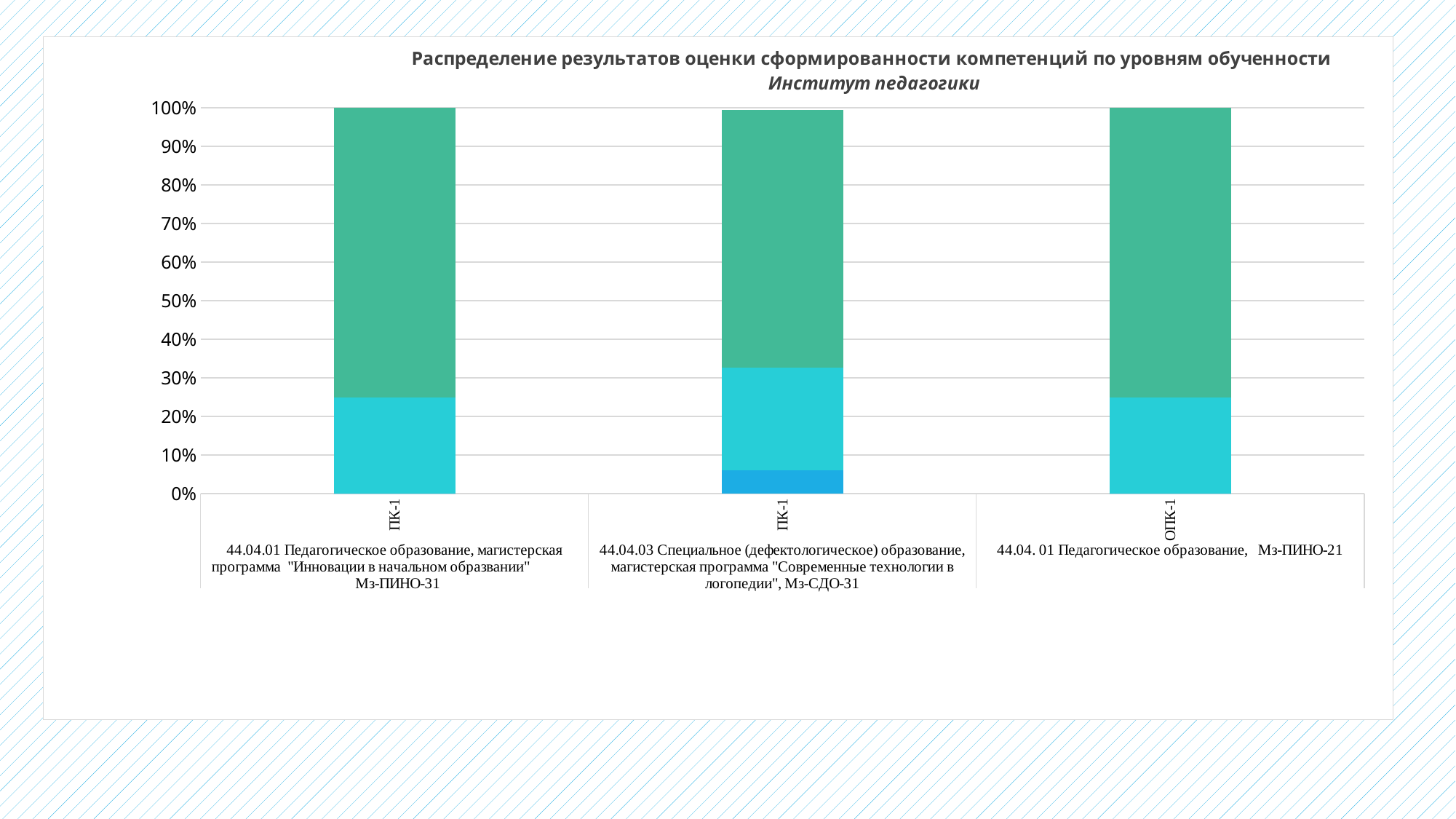
Which institute is named in the chart's subtitle? Институт педагогики Is the bottom (cyan) segment of the bar for Мз-ПИНО-31 greater or less than 30%? less Is the top (green) segment of the bar for Мз-ПИНО-21 greater or less than 70%? greater How many bars (programmes) are plotted in the chart? 3 Is the bottom (dark blue) segment of the bar for Мз-СДО-31 greater or less than 10%? less What is the title of the chart? Распределение результатов оценки сформированности компетенций по уровням обученности Which programme's bar is made up of three segments rather than two? Мз-СДО-31 What kind of chart is shown on the slide? stacked bar chart What is the total height of the stacked bar for Мз-ПИНО-31? 100% Which bar has the larger green (top) segment: Мз-ПИНО-31 or Мз-СДО-31? Мз-ПИНО-31 Which competency is shown for the programme Мз-ПИНО-21? ОПК-1